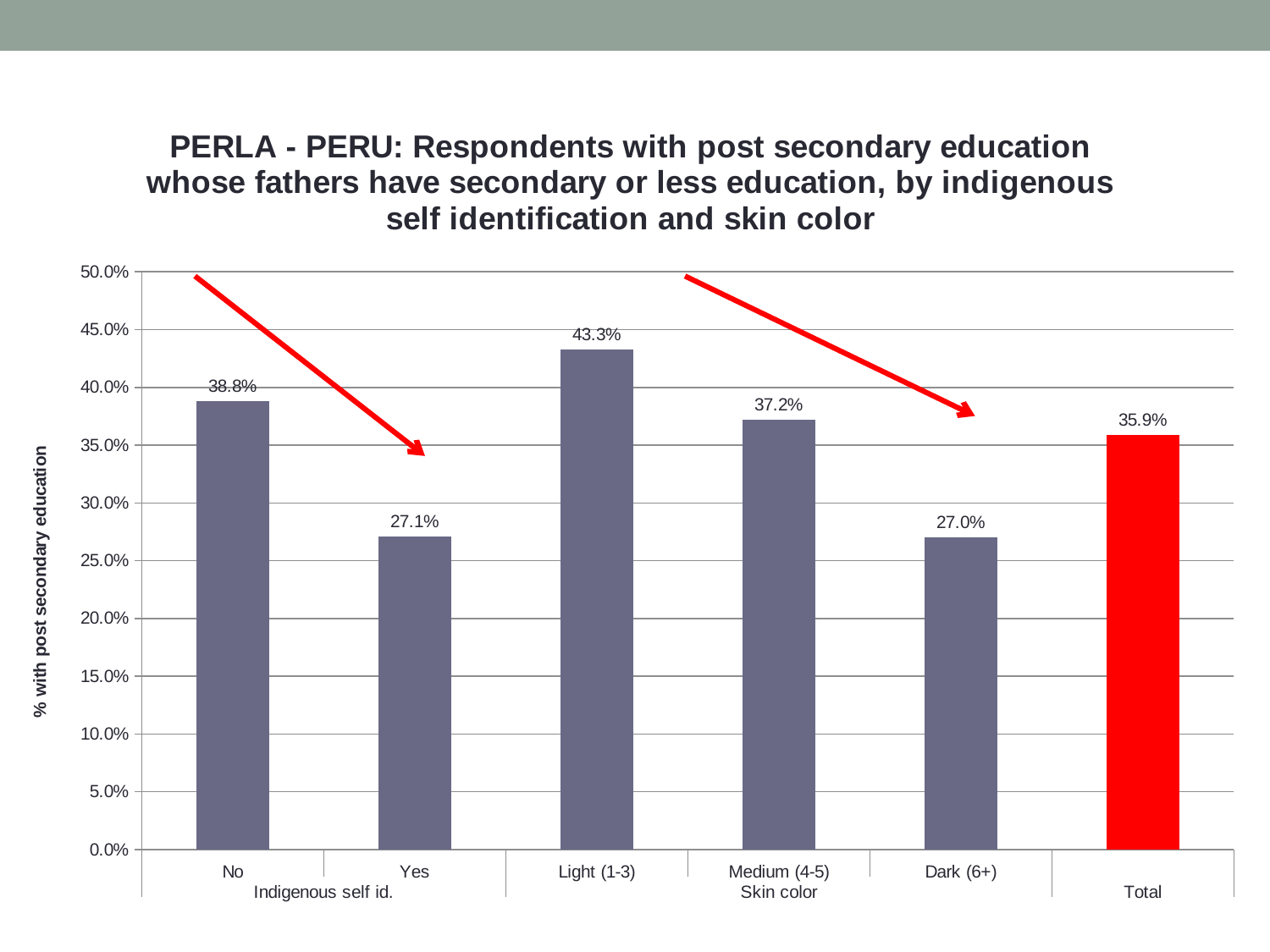
What is the difference between the values for "No" and "Yes" indigenous self identification? 11.7% What is the value for respondents who answered "No" to indigenous self identification? 38.8% What is the label of the vertical axis? % with post secondary education What is the value for the Total bar? 35.9% What is the difference between the Light (1-3) and Dark (6+) skin color values? 16.3% What is the value for respondents who answered "Yes" to indigenous self identification? 27.1% How many bars are plotted in the chart? 6 Which category has the lowest value? Dark (6+) What is the value for the Light (1-3) skin color category? 43.3% Which category has the highest value? Light (1-3) Which is larger, the value for Medium (4-5) skin color or the Total? Medium (4-5) What kind of chart is shown on the slide? Bar chart